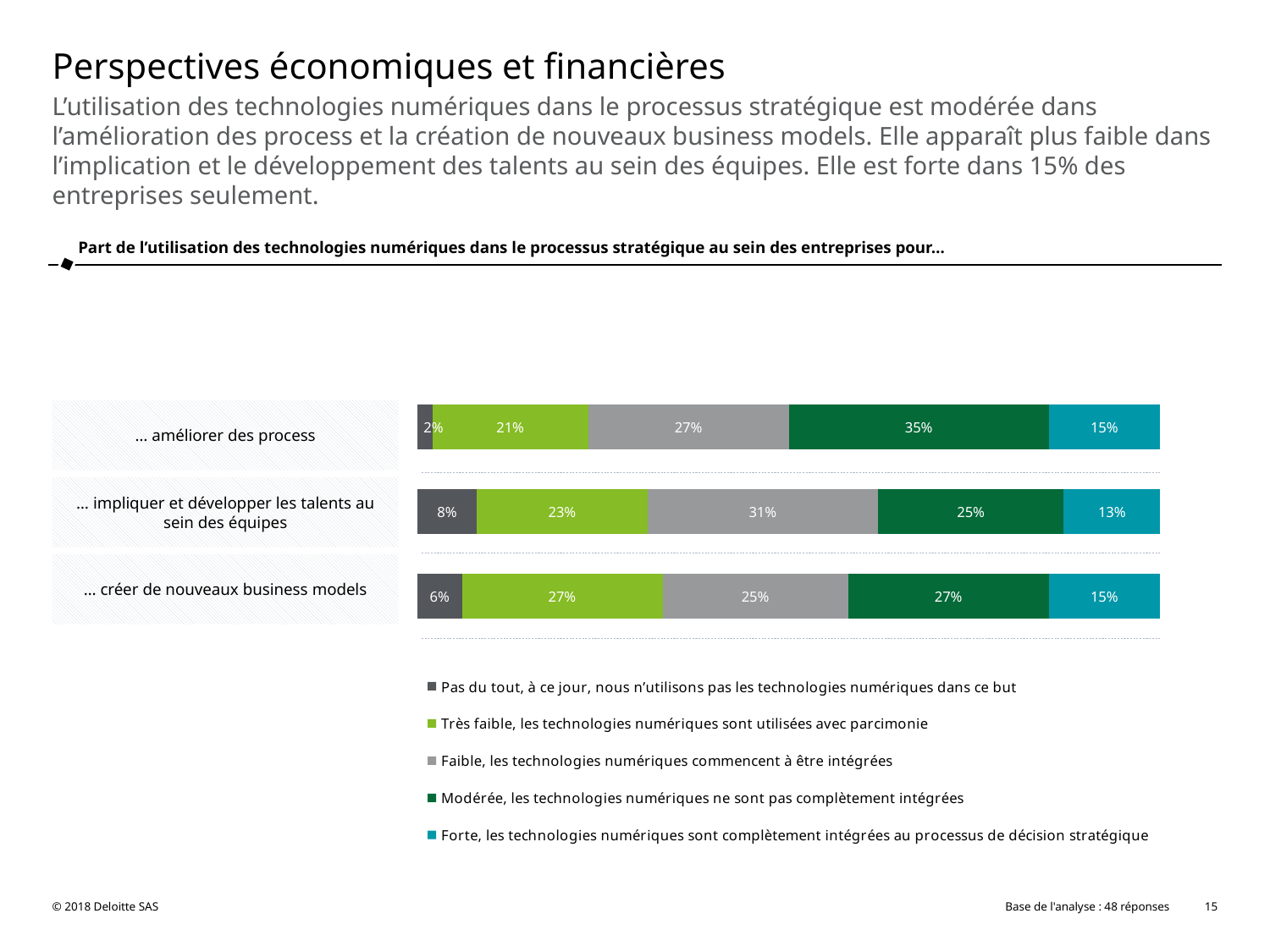
What is the value of the "Pas du tout" segment for "… impliquer et développer les talents au sein des équipes"? 8% Which is larger: the "Très faible" value for "… améliorer des process" or for "… impliquer et développer les talents au sein des équipes"? … impliquer et développer les talents au sein des équipes What kind of chart is shown on the slide? Stacked bar chart What is the value of the "Forte" segment for "… impliquer et développer les talents au sein des équipes"? 13% How many series does the legend list? 5 Which category has the lowest "Pas du tout" value? … améliorer des process What is the difference between the "Faible" values for "… impliquer et développer les talents au sein des équipes" and "… créer de nouveaux business models"? 6% Which category has the highest "Modérée" value? … améliorer des process What is the value of the "Très faible" segment for "… créer de nouveaux business models"? 27% What is the value of the "Modérée" segment for "… améliorer des process"? 35% How many categories are shown in the chart? 3 Which legend entry is shown in the darkest green colour? Modérée, les technologies numériques ne sont pas complètement intégrées